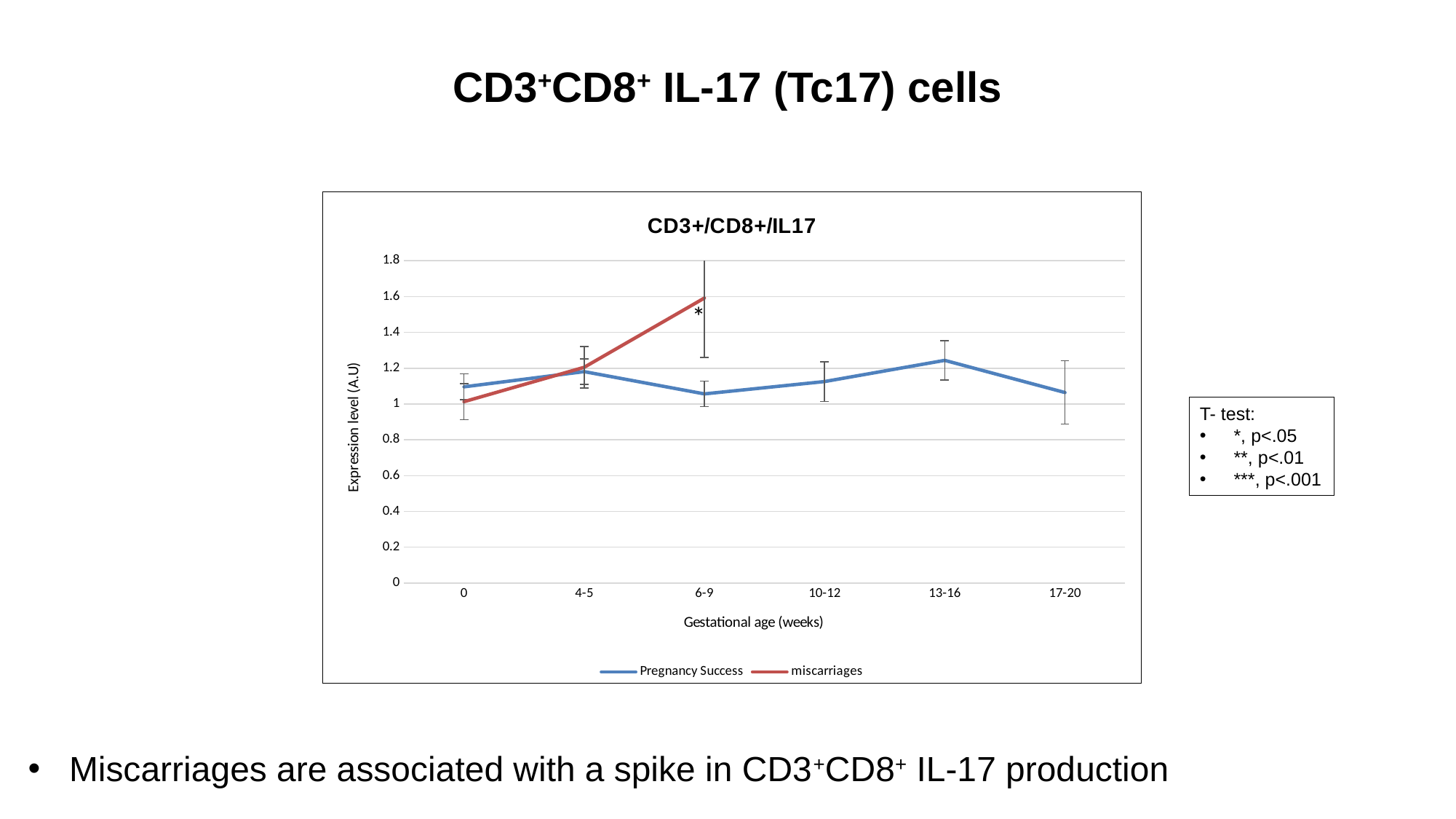
Is the value for Pregnancy Success at 6-9 weeks greater or less than 1.2? less Is the value for miscarriages at 6-9 weeks greater or less than 1.4? greater Is the value for miscarriages at 0 weeks greater or less than 1.2? less How many series does the chart legend list? 2 What kind of chart is shown on the slide? Line chart How many gestational age categories are shown on the x axis? 6 Does the miscarriages series rise or fall from 0 to 6-9 weeks? Rise At 6-9 weeks, which series has the larger value, Pregnancy Success or miscarriages? miscarriages What is the label of the x axis? Gestational age (weeks) At which gestational age is the miscarriages series highest? 6-9 What is the title of the chart? CD3+/CD8+/IL17 At which gestational age is the Pregnancy Success series highest? 13-16